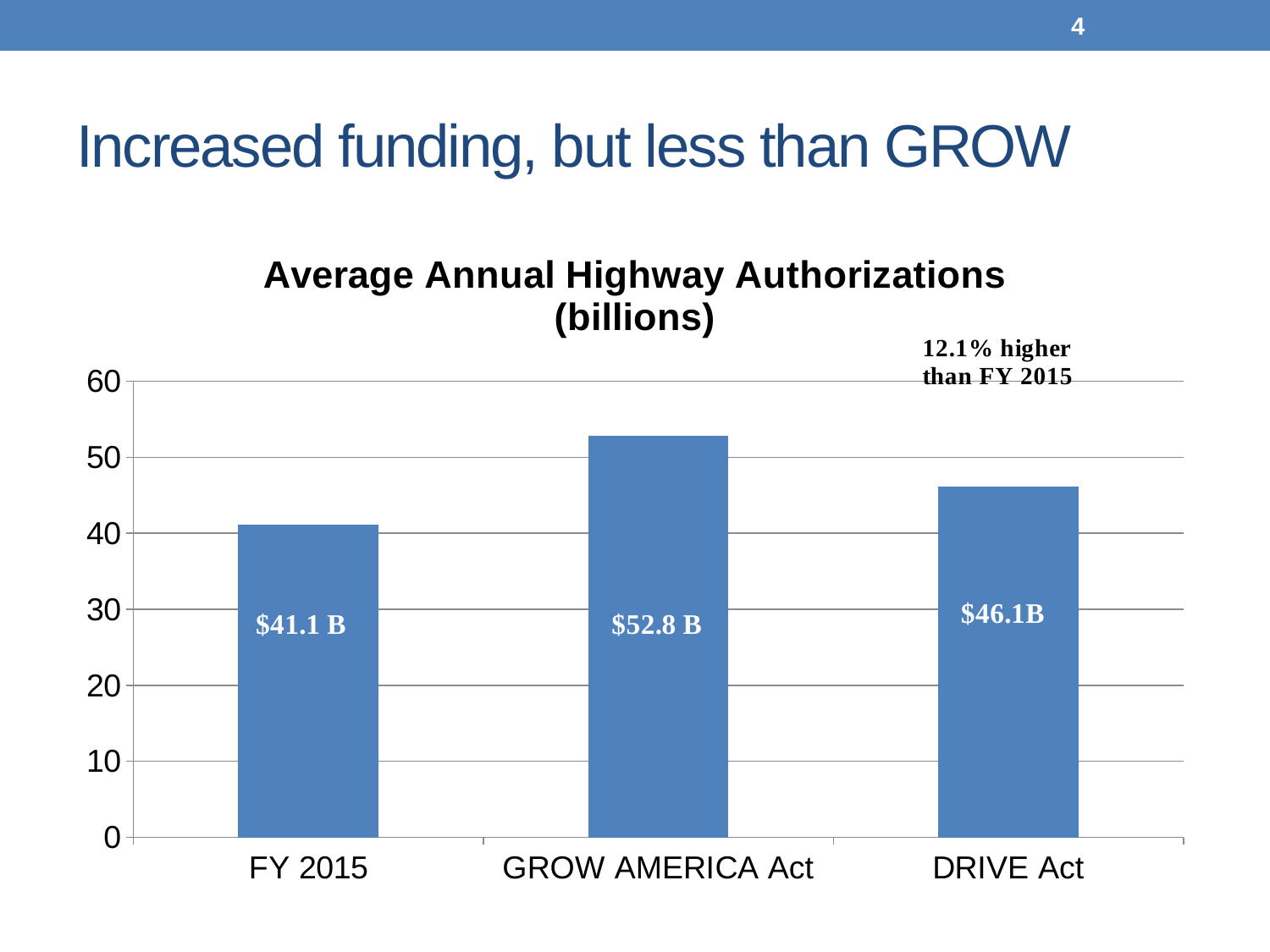
Is the value for the GROW AMERICA Act greater or less than 50? greater How much higher is the GROW AMERICA Act authorization than the DRIVE Act authorization, in billions? $6.7 B How much higher is the DRIVE Act authorization than the FY 2015 authorization, in billions? $5.0 B Which category has the lowest average annual highway authorization? FY 2015 Which category has the highest average annual highway authorization? GROW AMERICA Act How many categories are shown in the chart? 3 What is the title of the chart? Average Annual Highway Authorizations (billions) What kind of chart is shown on the slide? bar chart Which is larger, the DRIVE Act authorization or the FY 2015 authorization? DRIVE Act What is the average annual highway authorization for FY 2015? $41.1 B What is the average annual highway authorization under the GROW AMERICA Act? $52.8 B What is the average annual highway authorization under the DRIVE Act? $46.1B